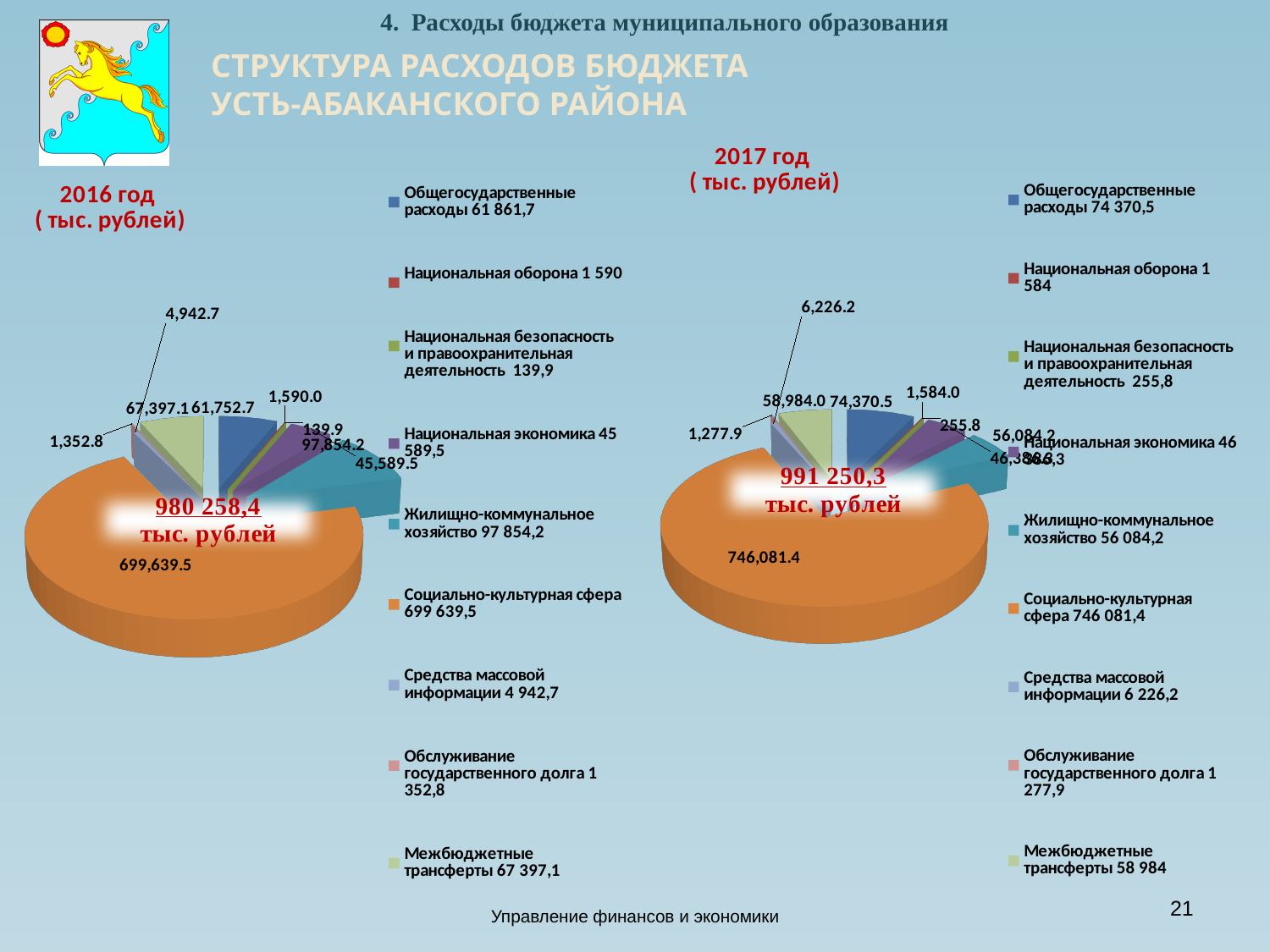
Which is larger: Социально-культурная сфера in 2016 or in 2017? 2017 In the 2017 pie chart, what is the value for Межбюджетные трансферты? 58,984.0 How many categories does the legend of the 2016 pie chart list? 9 In the 2016 pie chart, which category has the largest slice? Социально-культурная сфера In the 2016 pie chart, what is the value for Жилищно-коммунальное хозяйство? 97,854.2 What total is printed in the centre of the 2017 pie chart? 991 250,3 тыс. рублей In the 2016 pie chart, what is the value for Социально-культурная сфера? 699,639.5 In the 2016 pie chart, what is the difference between Жилищно-коммунальное хозяйство (97,854.2) and Национальная экономика (45,589.5)? 52,264.7 In the 2017 pie chart, what is the value for Средства массовой информации? 6,226.2 In the 2017 pie chart, what is the value for Социально-культурная сфера? 746,081.4 What type of charts are shown on the slide? Pie charts In the 2017 pie chart, which category has the smallest value? Национальная безопасность и правоохранительная деятельность